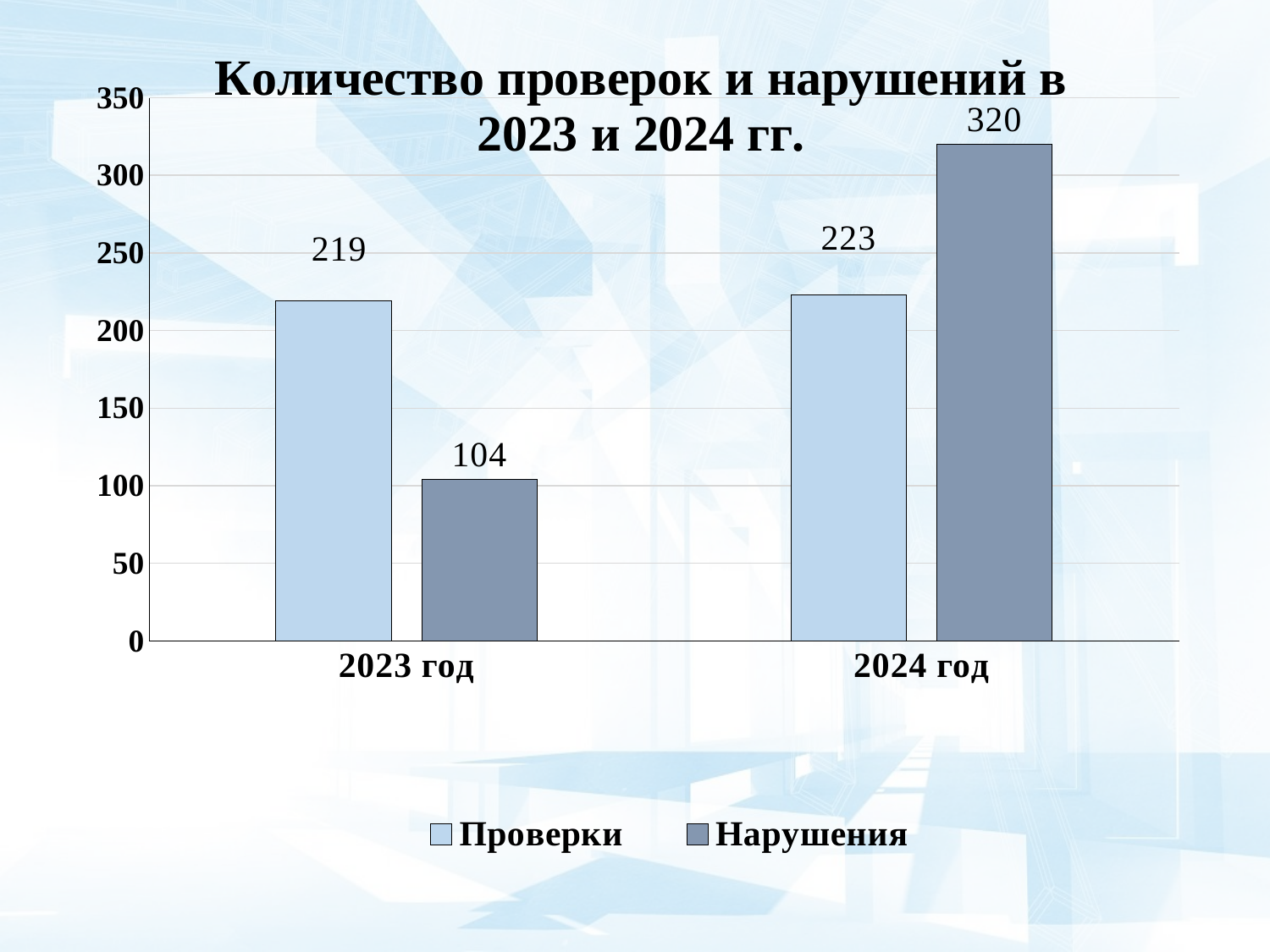
What is the value for Проверки in 2023 год? 219 What is the title of the chart? Количество проверок и нарушений в 2023 и 2024 гг. Which year has the highest value for Нарушения? 2024 год Which series has the lowest value in 2023 год? Нарушения Which is larger in 2024 год: Проверки or Нарушения? Нарушения What kind of chart is shown on the slide? Bar chart What is the value for Проверки in 2024 год? 223 What is the value for Нарушения in 2024 год? 320 What is the difference between Нарушения in 2024 год and Нарушения in 2023 год? 216 What is the value for Нарушения in 2023 год? 104 What is the difference between Проверки in 2024 год and Проверки in 2023 год? 4 How many series does the legend list? 2